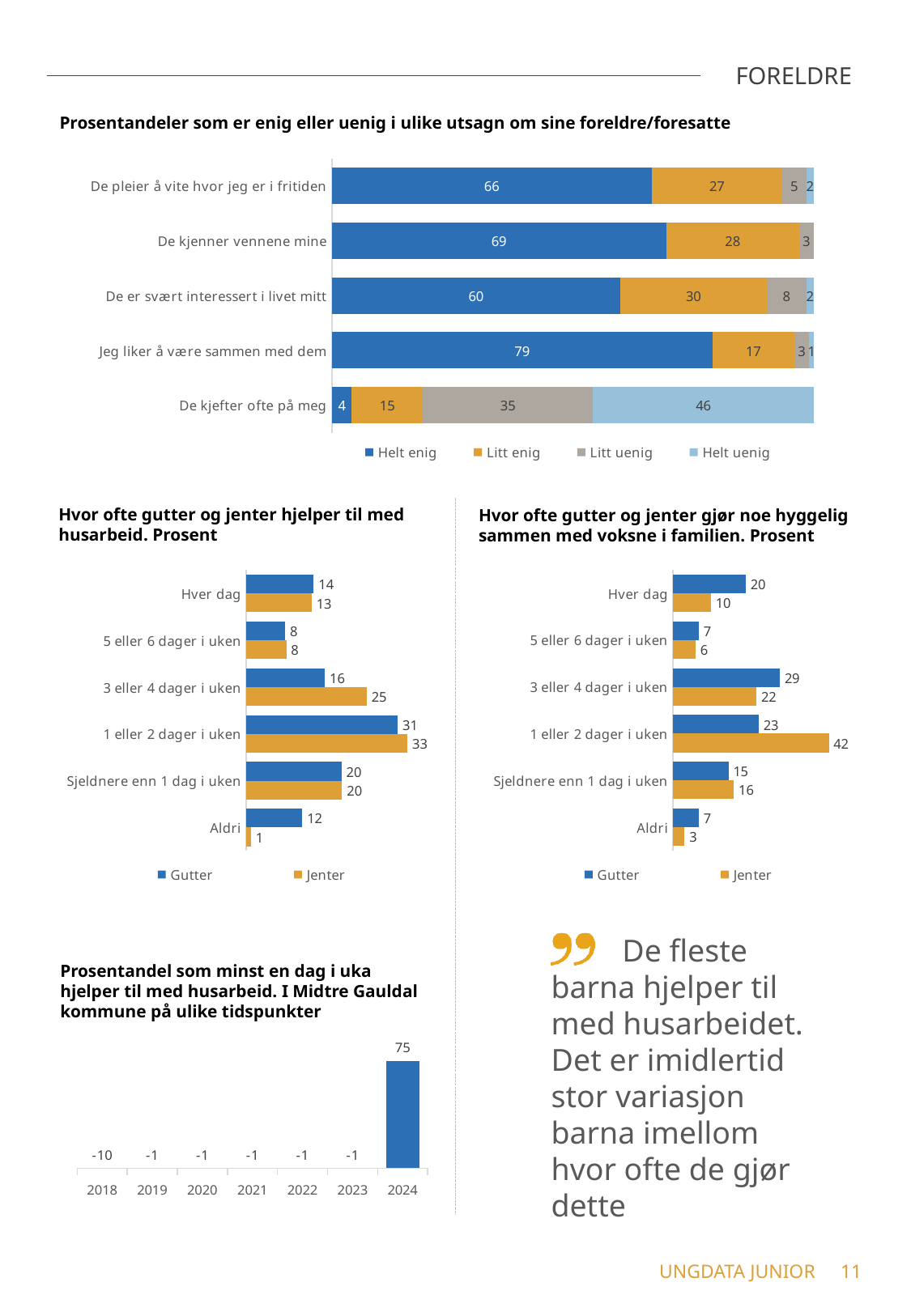
In the chart 'Hvor ofte gutter og jenter hjelper til med husarbeid. Prosent', how many categories are shown? 6 In the chart 'Prosentandeler som er enig eller uenig i ulike utsagn om sine foreldre/foresatte', which statement has the highest 'Helt enig' value? Jeg liker å være sammen med dem In the chart 'Prosentandeler som er enig eller uenig i ulike utsagn om sine foreldre/foresatte', what is the 'Helt enig' value for 'Jeg liker å være sammen med dem'? 79 In the chart 'Hvor ofte gutter og jenter gjør noe hyggelig sammen med voksne i familien. Prosent', which is larger for 'Hver dag': Gutter or Jenter? Gutter In the chart 'Hvor ofte gutter og jenter hjelper til med husarbeid. Prosent', what is the value for Jenter for '3 eller 4 dager i uken'? 25 In the chart 'Hvor ofte gutter og jenter hjelper til med husarbeid. Prosent', which category has the lowest value for Jenter? Aldri In the chart 'Prosentandeler som er enig eller uenig i ulike utsagn om sine foreldre/foresatte', what is the 'Helt uenig' value for 'De kjefter ofte på meg'? 46 In the chart 'Prosentandel som minst en dag i uka hjelper til med husarbeid. I Midtre Gauldal kommune på ulike tidspunkter', what is the value for 2024? 75 In the chart 'Prosentandeler som er enig eller uenig i ulike utsagn om sine foreldre/foresatte', what is the difference between the 'Helt enig' values for 'De kjenner vennene mine' and 'De er svært interessert i livet mitt'? 9 In the chart 'Hvor ofte gutter og jenter gjør noe hyggelig sammen med voksne i familien. Prosent', what is the value for Jenter for '1 eller 2 dager i uken'? 42 How many series does the legend list in the chart 'Prosentandeler som er enig eller uenig i ulike utsagn om sine foreldre/foresatte'? 4 In the chart 'Hvor ofte gutter og jenter gjør noe hyggelig sammen med voksne i familien. Prosent', what is the difference between Gutter and Jenter for '3 eller 4 dager i uken'? 7